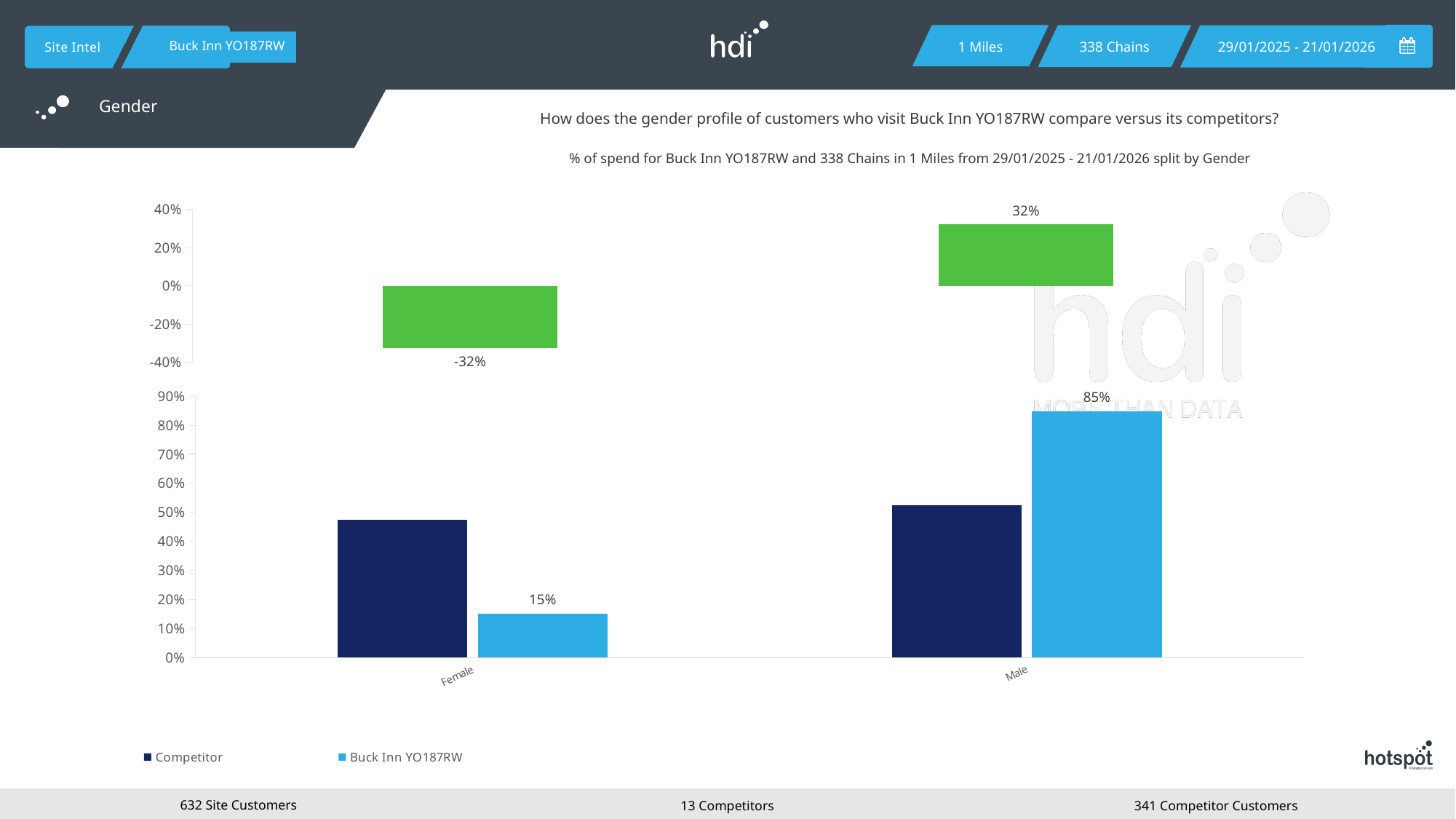
In the lower bar chart, what is the value for Buck Inn YO187RW for Female? 15% How many categories are shown on the x axis of the lower bar chart? 2 In the lower bar chart, which series has the larger value for Male, Competitor or Buck Inn YO187RW? Buck Inn YO187RW In the upper green difference chart, what is the value shown for Male? 32% In the lower bar chart, is the Competitor value for Male greater or less than 60%? less How many series does the legend of the lower bar chart list? 2 What kind of chart is the lower chart on the slide? Bar chart In the lower bar chart, what is the value for Buck Inn YO187RW for Male? 85% In the upper green difference chart, what is the value shown for Female? -32% In the lower bar chart, which series has the larger value for Female, Competitor or Buck Inn YO187RW? Competitor In the lower bar chart, is the Competitor value for Female greater or less than 40%? greater In the lower bar chart, what is the difference between the Buck Inn YO187RW values for Male and Female? 70%